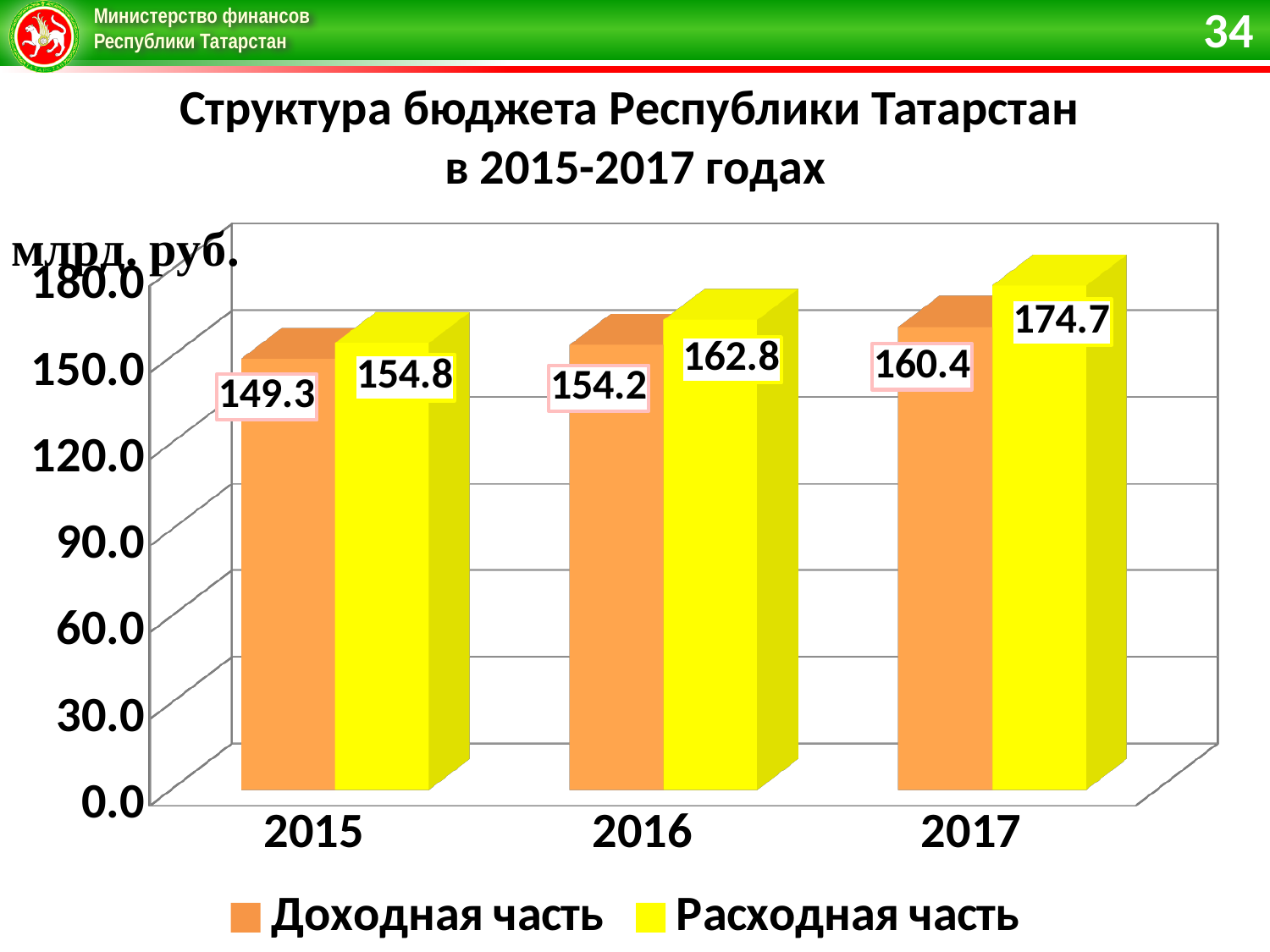
In which year is Доходная часть highest? 2017 What is the difference between Расходная часть and Доходная часть in 2017? 14.3 What is the value of Расходная часть for 2016? 162.8 How many series does the legend list? 2 Which is larger in 2016: Доходная часть or Расходная часть? Расходная часть What is the difference between Доходная часть in 2016 and in 2015? 4.9 What is the value of Доходная часть for 2015? 149.3 In which year is Расходная часть lowest? 2015 What is the value of Расходная часть for 2017? 174.7 How many years are shown on the x axis? 3 What kind of chart is shown on the slide? bar chart Does Расходная часть rise or fall from 2015 to 2017? rise